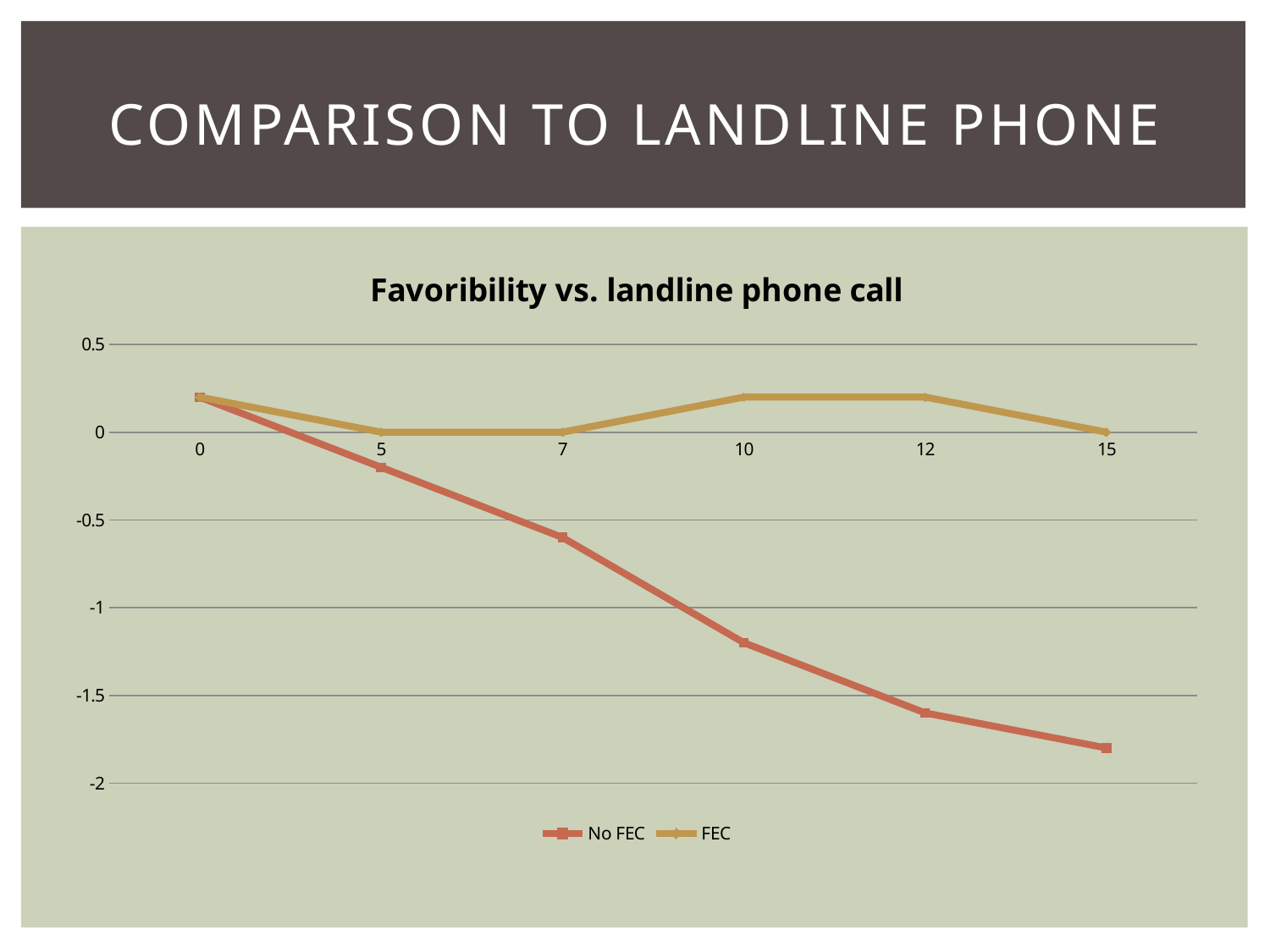
What is the value of the FEC series at x = 15? 0 Is the value of the No FEC series at x = 7 greater or less than -1? greater Is the value of the No FEC series at x = 10 greater or less than -1? less At x = 12, which series has the larger value, No FEC or FEC? FEC At which x value does the No FEC series reach its lowest value? 15 How many points are plotted along the x axis for each series? 6 Does the No FEC series rise or fall as x increases from 0 to 15? fall What is the value of the FEC series at x = 5? 0 How many series does the legend list? 2 What kind of chart is shown on the slide? line chart What is the title of the chart? Favoribility vs. landline phone call Is the value of the No FEC series at x = 15 greater or less than -1.5? less